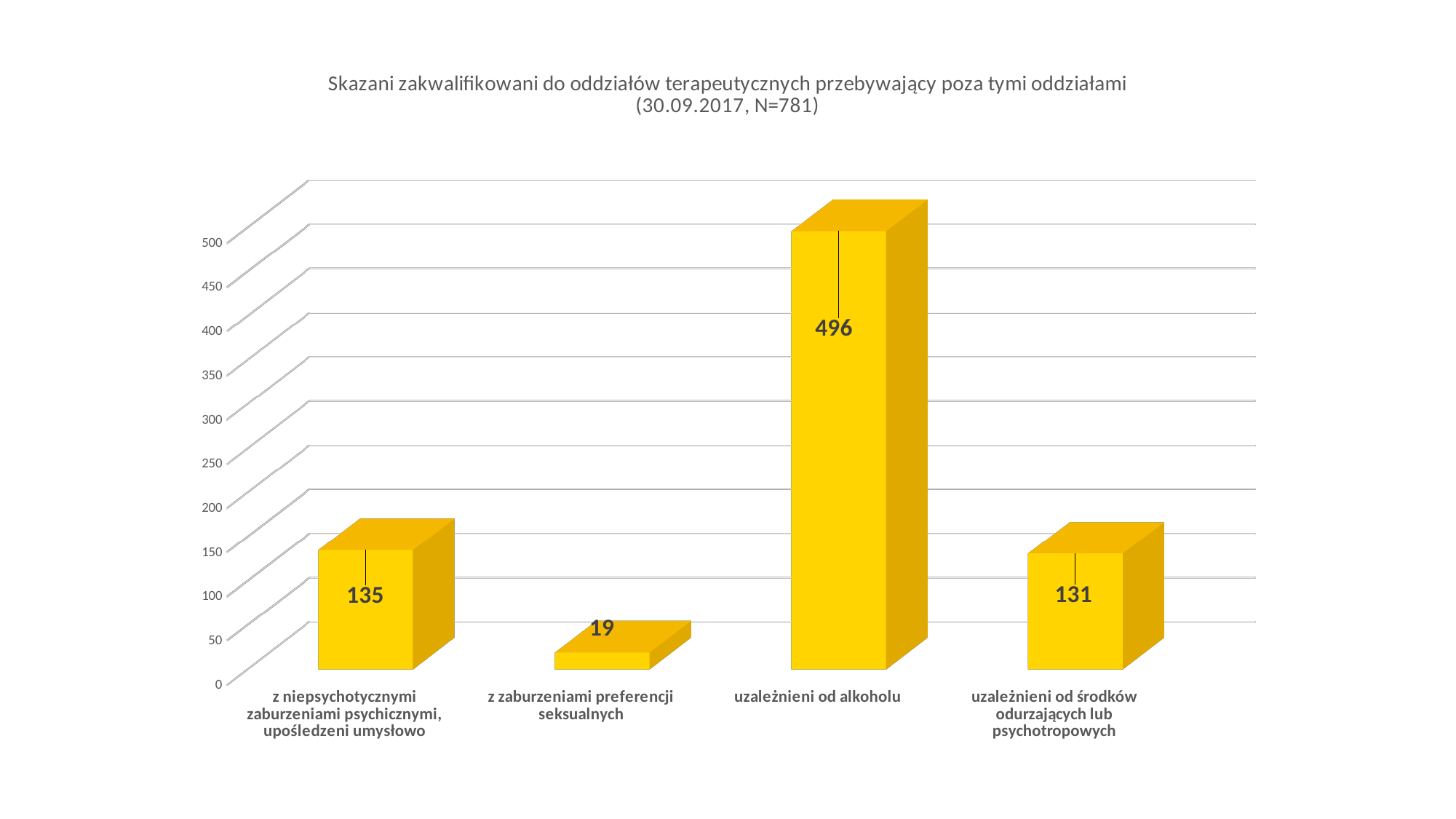
What is the value for 'z zaburzeniami preferencji seksualnych'? 19 What is the difference between the values for 'z niepsychotycznymi zaburzeniami psychicznymi, upośledzeni umysłowo' and 'uzależnieni od środków odurzających lub psychotropowych'? 4 How many categories are shown on the chart? 4 What kind of chart is shown on the slide? bar chart What is the value for 'z niepsychotycznymi zaburzeniami psychicznymi, upośledzeni umysłowo'? 135 Which is larger: the value for 'z niepsychotycznymi zaburzeniami psychicznymi, upośledzeni umysłowo' or the value for 'z zaburzeniami preferencji seksualnych'? z niepsychotycznymi zaburzeniami psychicznymi, upośledzeni umysłowo Which category has the lowest value? z zaburzeniami preferencji seksualnych What date and N value are given in the chart title? 30.09.2017, N=781 What is the value for 'uzależnieni od środków odurzających lub psychotropowych'? 131 What is the difference between the values for 'uzależnieni od alkoholu' and 'z zaburzeniami preferencji seksualnych'? 477 What is the value for 'uzależnieni od alkoholu'? 496 Which category has the highest value? uzależnieni od alkoholu